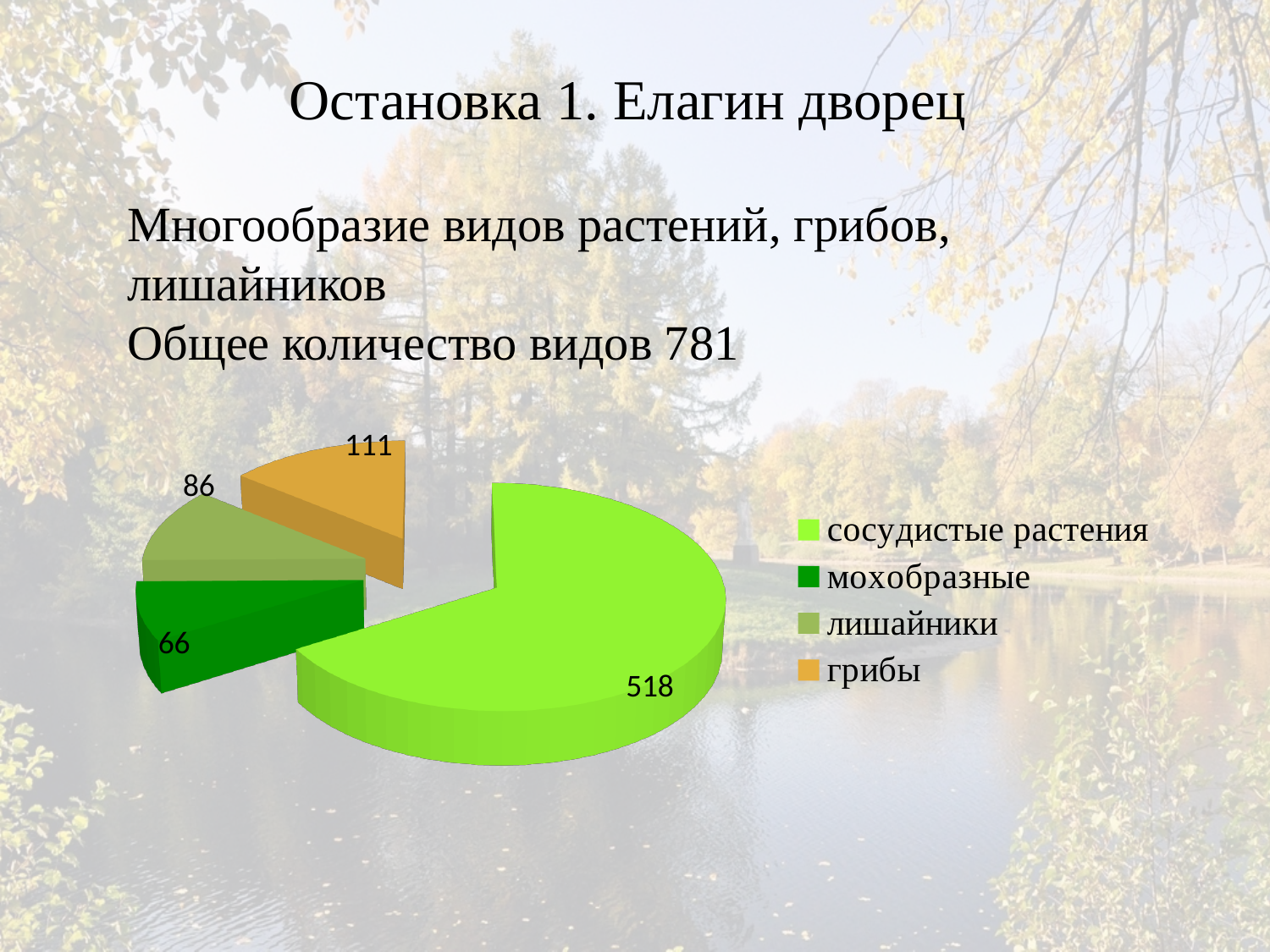
What kind of chart is shown on the slide? pie chart Which category has the largest slice of the pie? сосудистые растения How many categories does the pie chart have? 4 What is the value for мохобразные in the pie chart? 66 What is the value for лишайники in the pie chart? 86 Which is larger, the value for лишайники or the value for мохобразные? лишайники What colour is the slice for грибы? orange What is the difference between the values for грибы and лишайники? 25 How many species are shown for сосудистые растения? 518 Which category has the smallest slice of the pie? мохобразные What is the total of all slices in the pie chart? 781 What is the value for грибы in the pie chart? 111